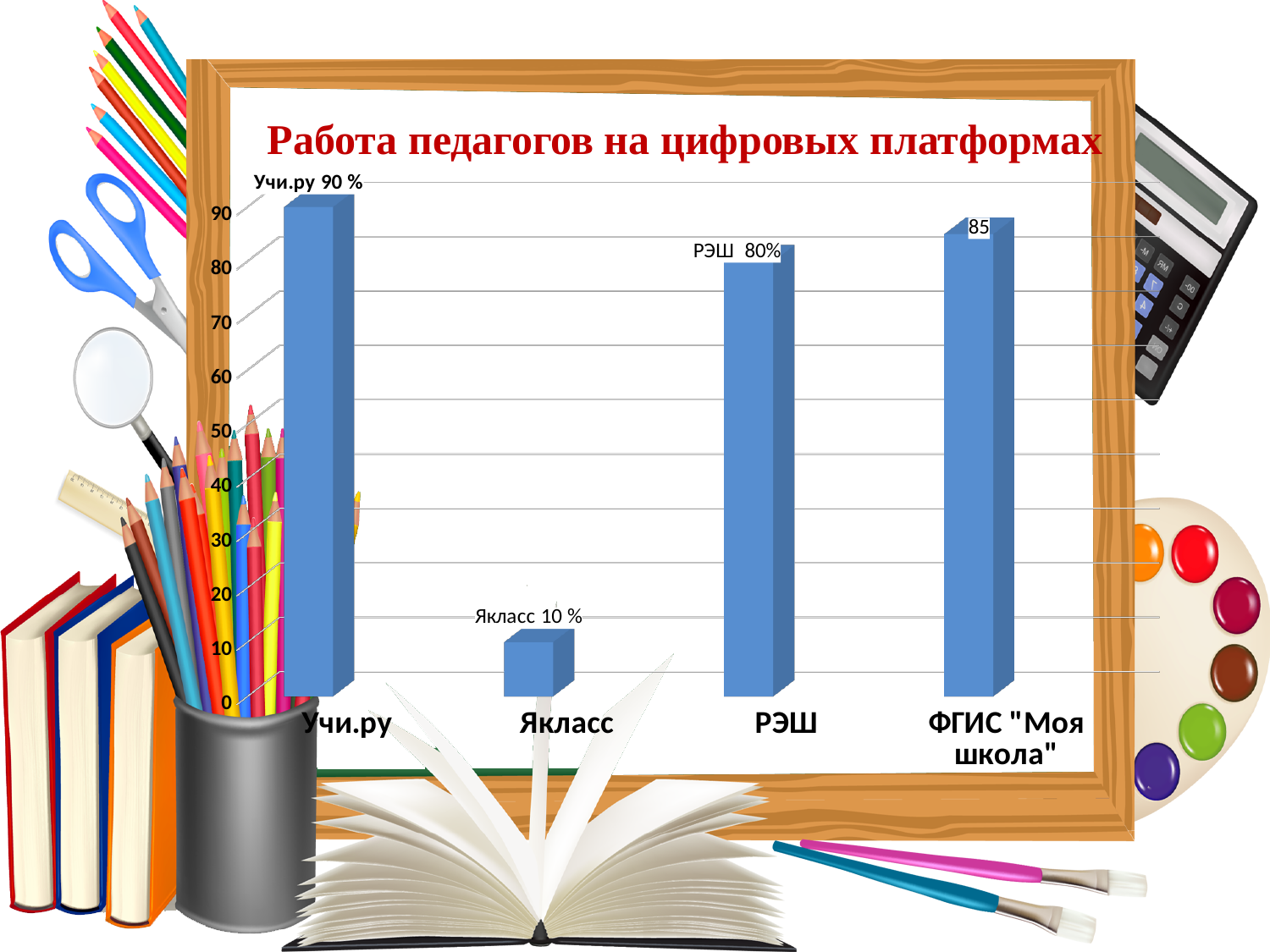
Which is larger, the value for РЭШ or the value for ФГИС "Моя школа"? ФГИС "Моя школа" What is the title of the chart? Работа педагогов на цифровых платформах What is the value shown for РЭШ? 80% Which category has the highest value? Учи.ру What type of chart is shown on the slide? bar chart Which category has the lowest value? Якласс What is the value shown for Якласс? 10 % How many categories are shown on the chart? 4 Is the value for Якласс greater or less than 20? less What is the difference between the values for Учи.ру and Якласс? 80 What is the value shown for ФГИС "Моя школа"? 85 What is the value shown for Учи.ру? 90 %